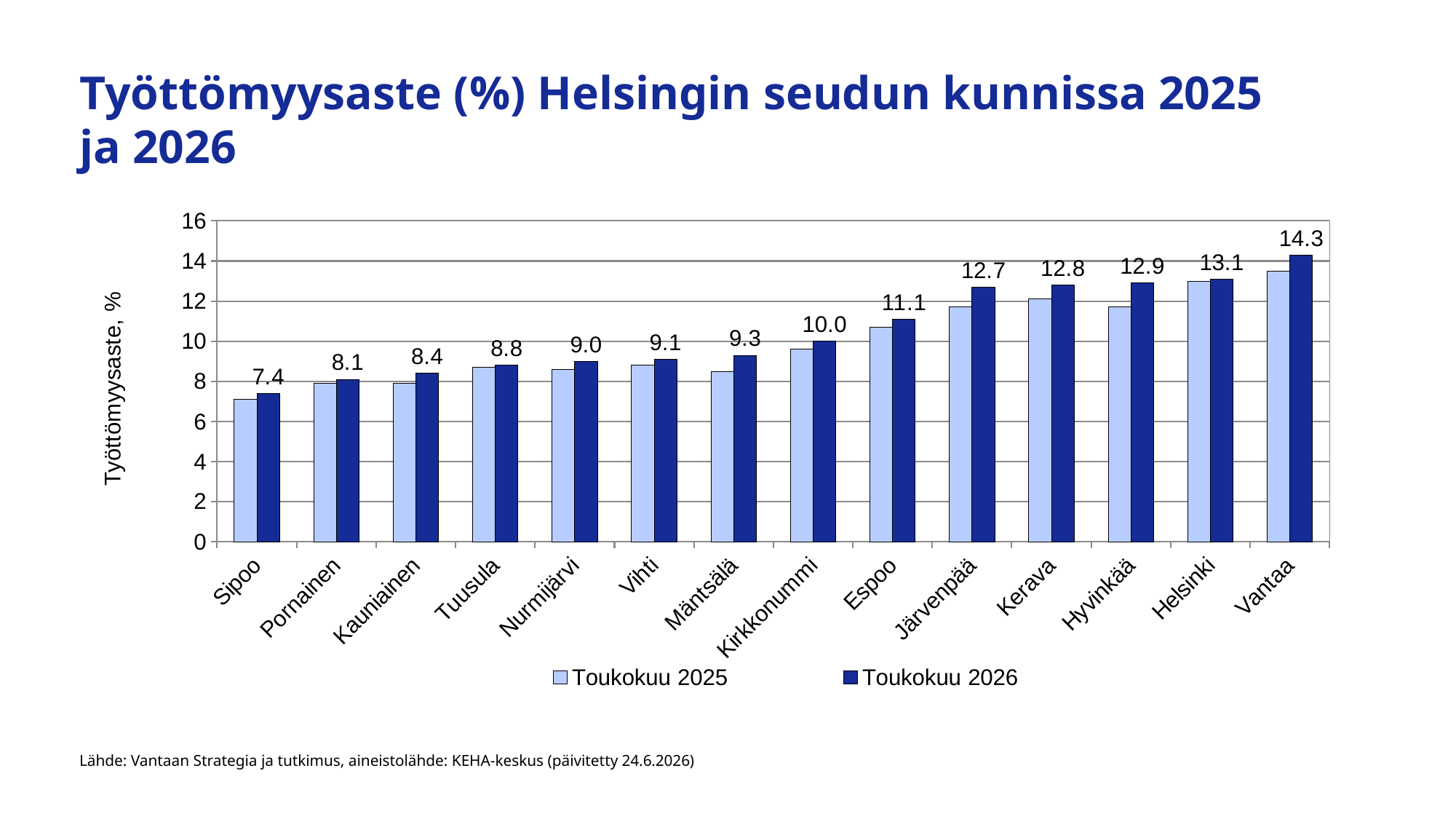
What is the Toukokuu 2026 value for Kirkkonummi? 10.0 Which municipality has the lowest Toukokuu 2026 unemployment rate? Sipoo What is the Toukokuu 2026 unemployment rate for Vantaa? 14.3 How many series does the legend list? 2 How many municipalities are shown on the x axis? 14 Which municipality has the highest Toukokuu 2026 unemployment rate? Vantaa What is the Toukokuu 2026 value for Espoo? 11.1 What is the difference between the Toukokuu 2026 values for Vantaa and Helsinki? 1.2 Is the Toukokuu 2025 value for Vantaa greater or less than 12? greater Which has a higher Toukokuu 2026 value, Järvenpää or Tuusula? Järvenpää What type of chart is shown on the slide? Bar chart Is the Toukokuu 2025 value for Sipoo greater or less than 8? less